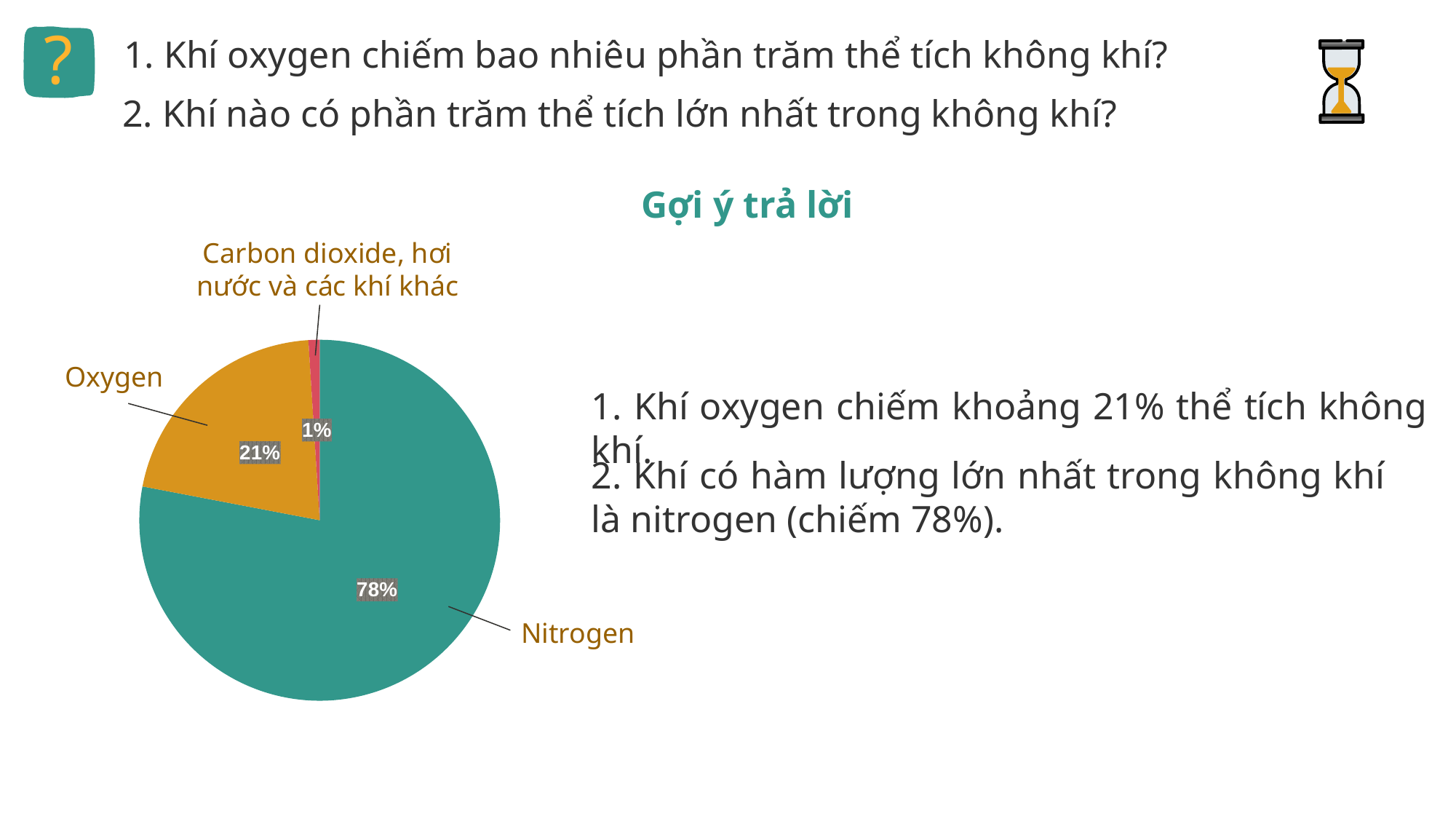
What share of the pie does Oxygen represent? 21% How many slices does the pie chart have? 3 Which slice of the pie is the largest? Nitrogen What percentage does the Oxygen slice show? 21% What kind of chart is shown on the slide? pie chart What percentage does the slice labelled 'Carbon dioxide, hơi nước và các khí khác' show? 1% Which slice of the pie is the smallest? Carbon dioxide, hơi nước và các khí khác What percentage does the Nitrogen slice show? 78% What is the difference in percentage points between the Nitrogen slice and the Oxygen slice? 57 What colour is the Nitrogen slice? teal Which is larger, the Oxygen slice or the Nitrogen slice? Nitrogen What colour is the Oxygen slice? orange